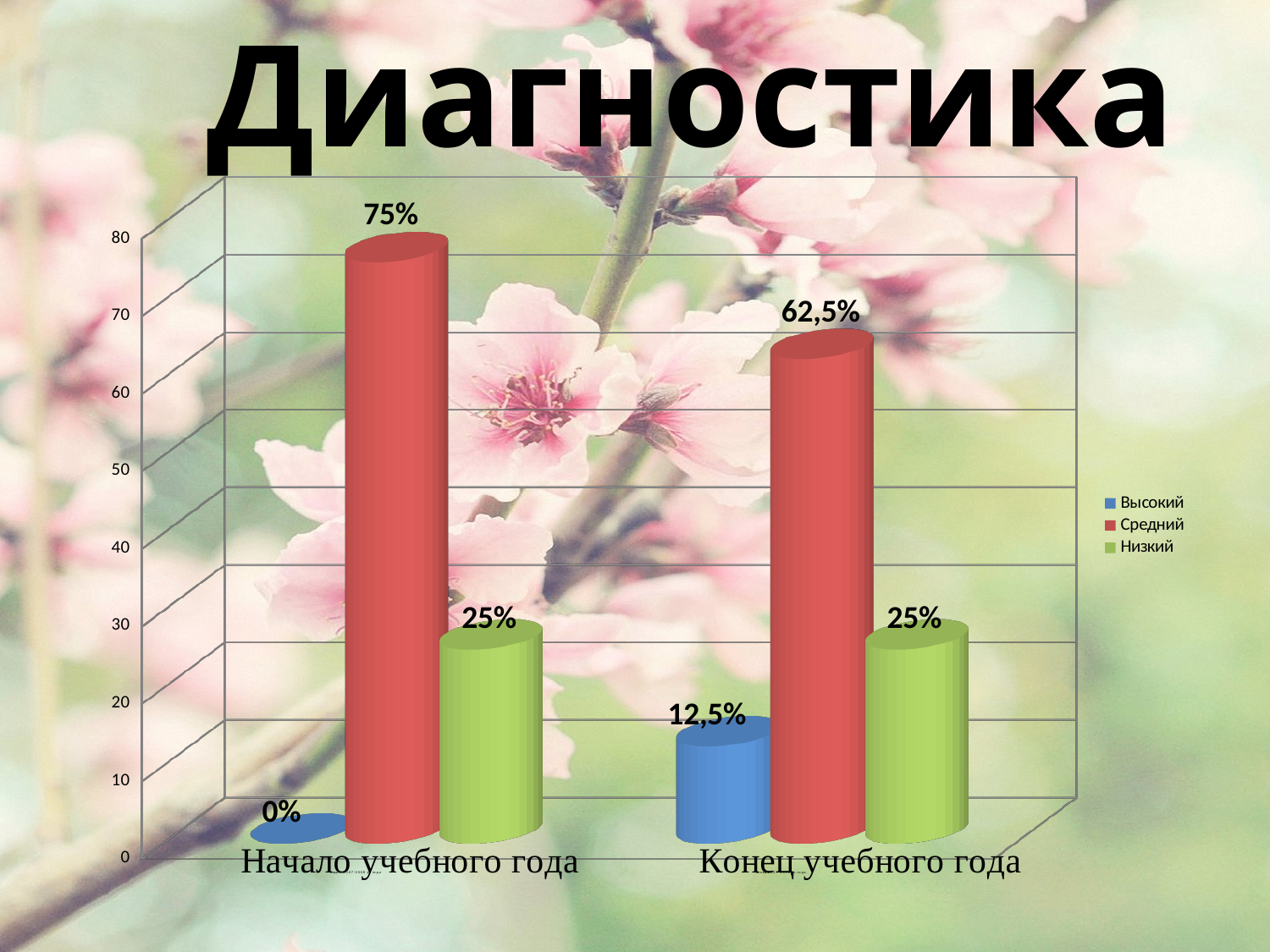
Does the Средний value rise or fall from Начало учебного года to Конец учебного года? Fall What is the value for Высокий at Начало учебного года? 0% What kind of chart is shown on the slide? Bar chart How many series does the legend list? 3 How many categories are shown on the x axis? 2 Which series has the highest value at Конец учебного года? Средний What is the value for Высокий at Конец учебного года? 12,5% Which is larger: Высокий at Конец учебного года or Низкий at Конец учебного года? Низкий Which series has the lowest value at Начало учебного года? Высокий What is the value for Средний at Начало учебного года? 75% What is the difference between the Средний values at Начало учебного года and Конец учебного года? 12,5% What is the value for Низкий at Начало учебного года? 25%